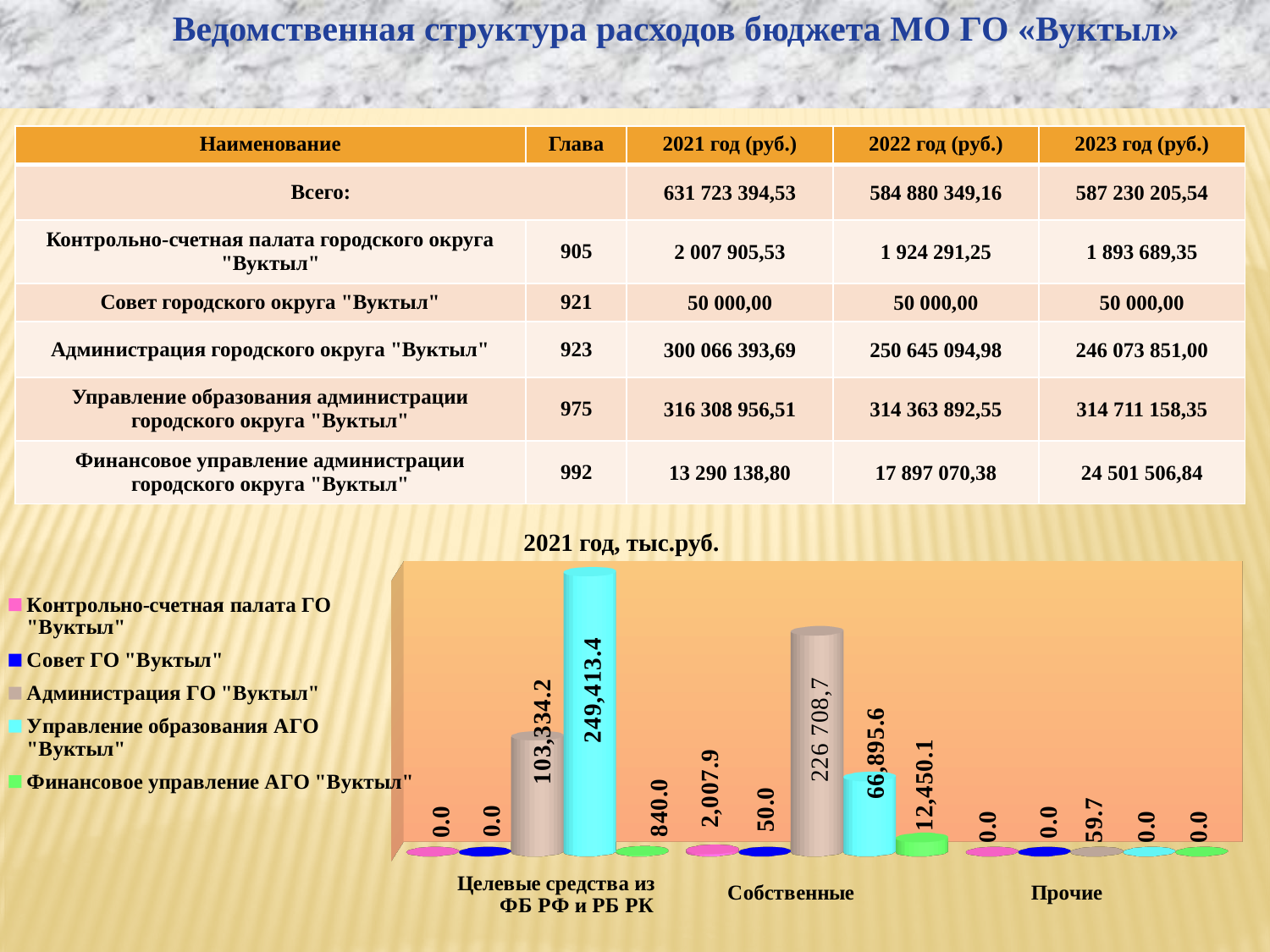
What is the value for Администрация ГО "Вуктыл" in the category Прочие? 59.7 What is the value for Контрольно-счетная палата ГО "Вуктыл" in the category Собственные? 2,007.9 In the category Собственные, which is larger: the value for Управление образования АГО "Вуктыл" or the value for Финансовое управление АГО "Вуктыл"? Управление образования АГО "Вуктыл" Which series has the highest value in the category Собственные? Администрация ГО "Вуктыл" How many categories are shown on the x axis of the chart? 3 What is the value for Администрация ГО "Вуктыл" in the category Собственные? 226 708,7 What kind of chart is shown at the bottom of the slide? bar chart Which series has the highest value in the category Целевые средства из ФБ РФ и РБ РК? Управление образования АГО "Вуктыл" What is the title of the chart? 2021 год, тыс.руб. What is the value for Финансовое управление АГО "Вуктыл" in the category Собственные? 12,450.1 What is the value for Управление образования АГО "Вуктыл" in the category Целевые средства из ФБ РФ и РБ РК? 249,413.4 How many series does the chart legend list? 5